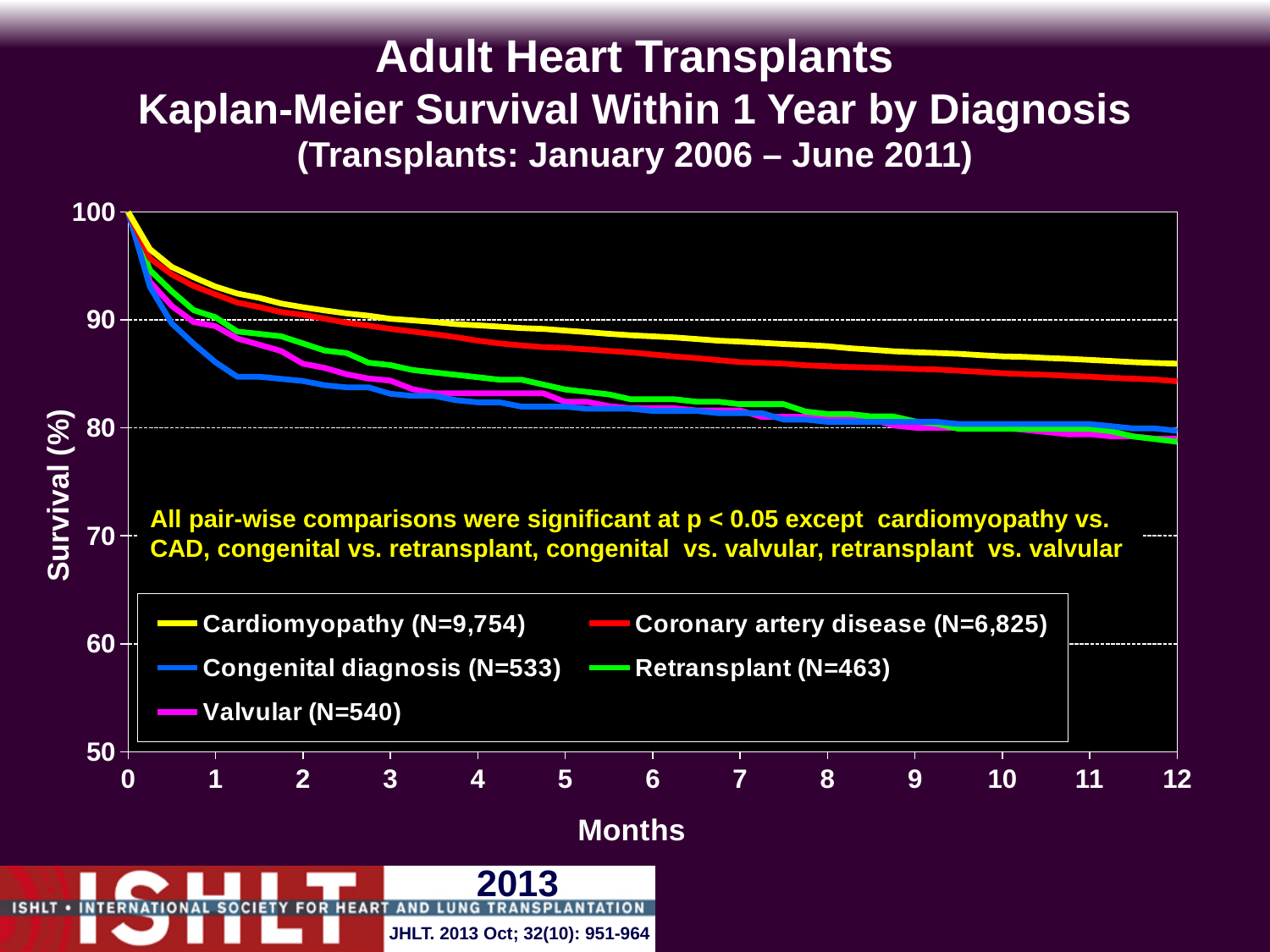
Which diagnosis group has the highest survival at 12 months? Cardiomyopathy (N=9,754) At 6 months, which is larger: survival for Cardiomyopathy or for Congenital diagnosis? Cardiomyopathy Is the survival for Cardiomyopathy at 12 months greater or less than 80? greater How many series does the legend list? 5 What kind of chart is shown on the slide? Line chart Is the survival for Coronary artery disease at 12 months greater or less than 80? greater Do the survival curves rise or fall as months increase? Fall What is the label of the y axis? Survival (%) Is the survival for Congenital diagnosis at 1 month greater or less than 90? less What is the N shown in the legend for Valvular? 540 At 12 months, which is larger: survival for Coronary artery disease or for Retransplant? Coronary artery disease Which diagnosis group has the lowest survival at 1 month? Congenital diagnosis (N=533)